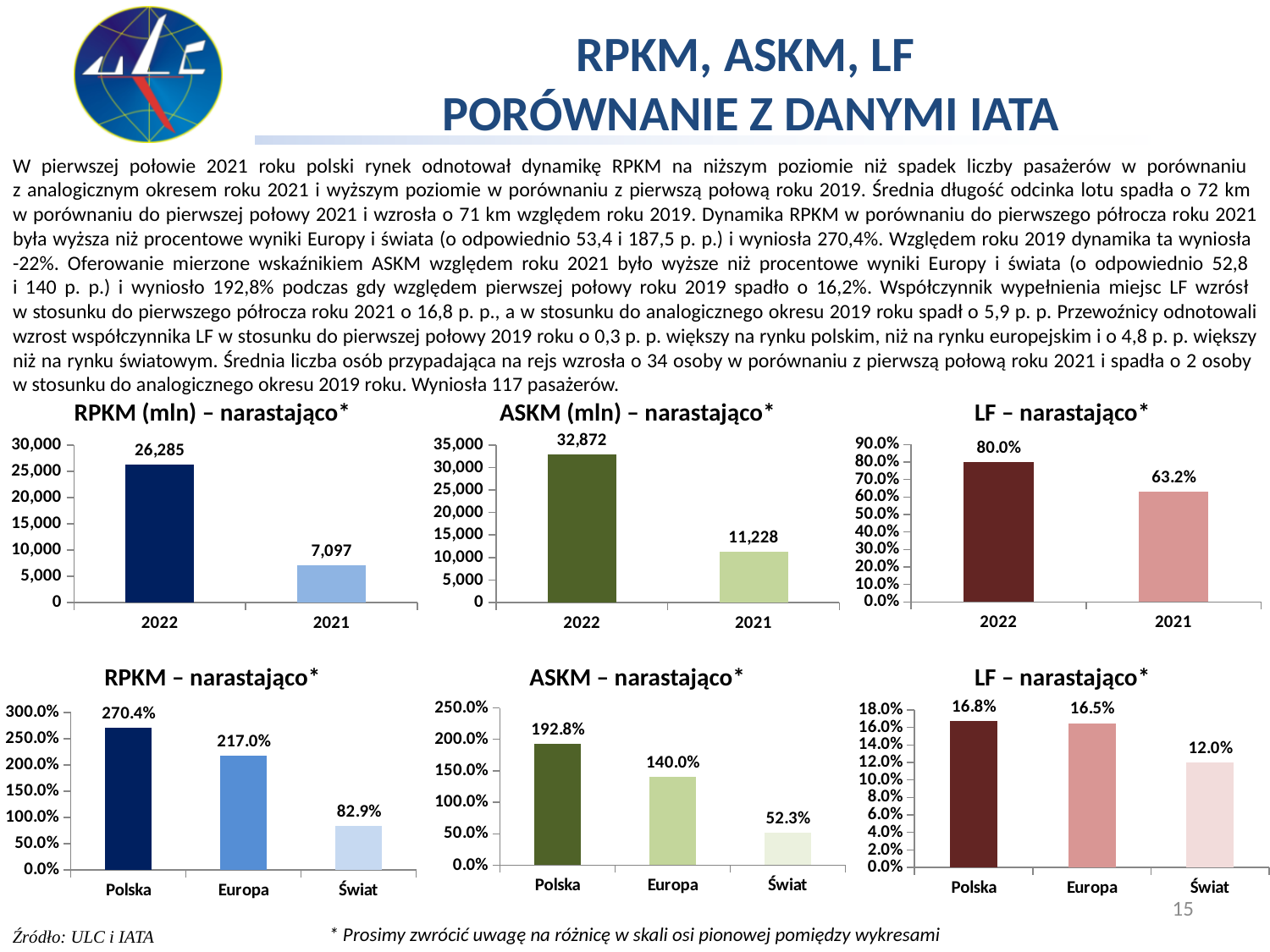
In the bottom-middle chart 'ASKM – narastająco*', what is the value for Polska? 192.8% In the bottom-left chart 'RPKM – narastająco*', which category has the lowest value? Świat In the top-left chart 'RPKM (mln) – narastająco*', what is the value for 2021? 7,097 In the top-right chart 'LF – narastająco*', which year has the higher value, 2022 or 2021? 2022 In the bottom-left chart 'RPKM – narastająco*', what is the value for Europa? 217.0% In the bottom-middle chart 'ASKM – narastająco*', how many categories are shown? 3 In the bottom-middle chart 'ASKM – narastająco*', do the values rise or fall from Polska to Świat? Fall In the top-left chart 'RPKM (mln) – narastająco*', what is the value for 2022? 26,285 In the bottom-right chart 'LF – narastająco*', what is the difference between the values for Polska and Świat? 4.8% What type of chart is the bottom-right chart 'LF – narastająco*'? Bar chart In the top-middle chart 'ASKM (mln) – narastająco*', what is the difference between the 2022 and 2021 values? 21,644 In the top-right chart 'LF – narastająco*', what is the value for 2021? 63.2%